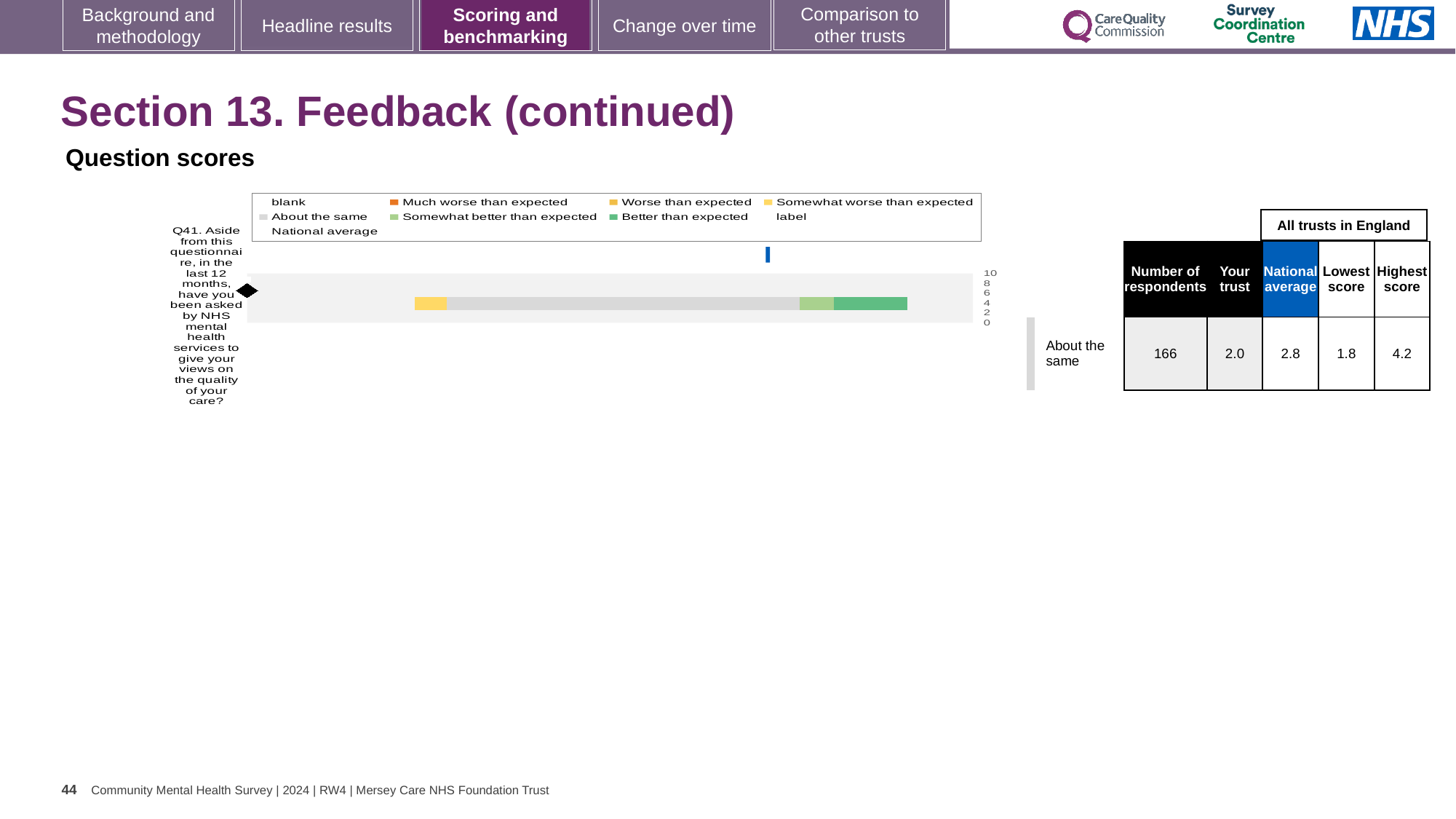
What is the difference between the highest and lowest scores for Q41 across all trusts in England? 2.4 Which question is plotted in the chart? Q41. Aside from this questionnaire, in the last 12 months, have you been asked by NHS mental health services to give your views on the quality of your care? How many respondents answered Q41? 166 What is the lowest score among all trusts in England for Q41? 1.8 What is the national average score for Q41? 2.8 What is the highest score among all trusts in England for Q41? 4.2 How many survey questions are plotted in the chart? 1 What is the 'Your trust' score for Q41? 2.0 In the chart legend, which colour represents 'Better than expected'? green What type of chart is used to show the Q41 question score? bar chart What benchmark category is the trust's Q41 score placed in? About the same Is the 'Your trust' score for Q41 higher or lower than the national average? lower